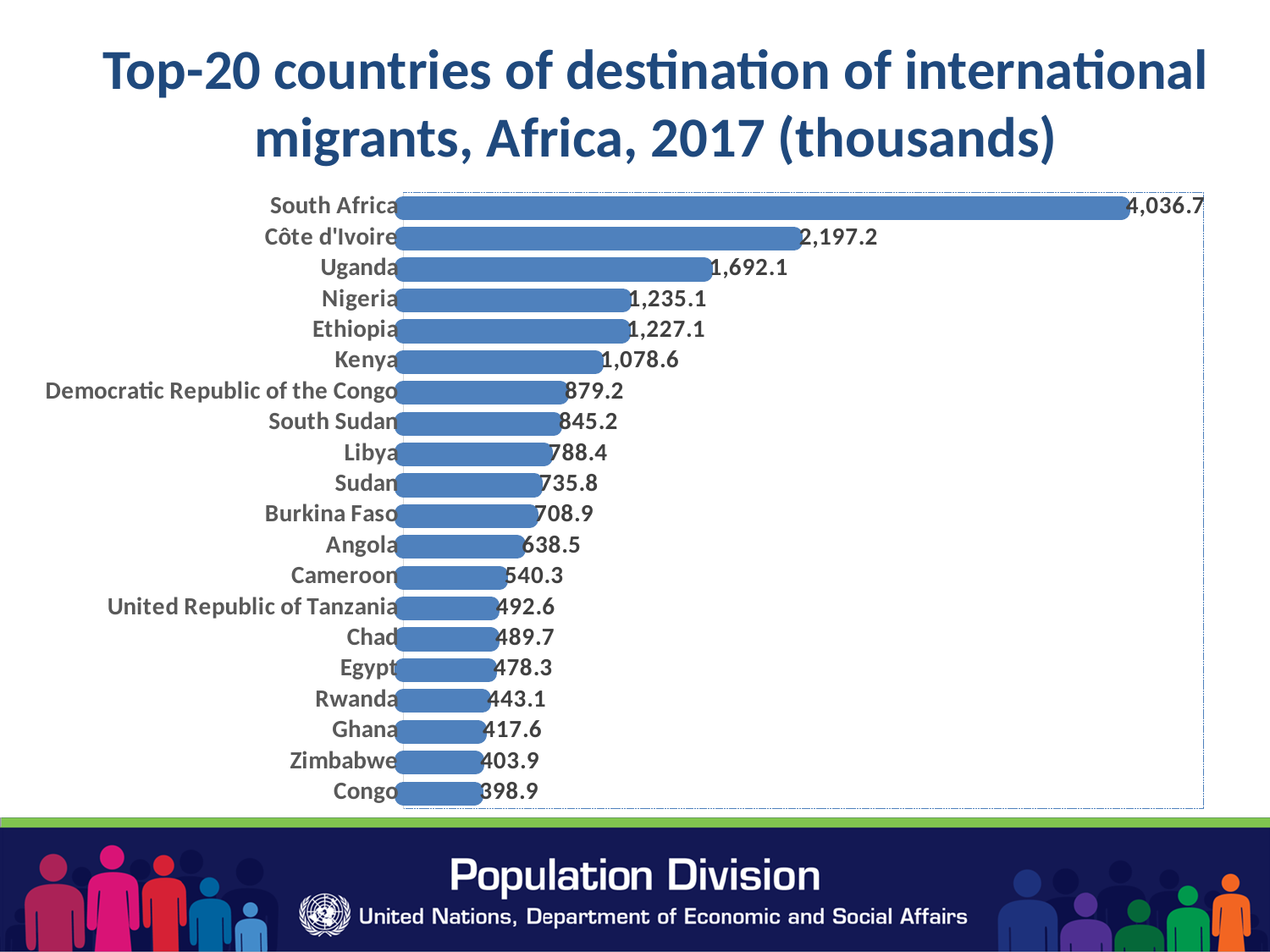
What is the value for Egypt? 478.3 Which country has the highest value? South Africa What kind of chart is shown on the slide? Bar chart What is the title of the chart? Top-20 countries of destination of international migrants, Africa, 2017 (thousands) What is the value for South Africa? 4,036.7 Which country has the lowest value? Congo How many countries are shown in the chart? 20 What is the value for Uganda? 1,692.1 What is the value for Democratic Republic of the Congo? 879.2 What is the difference between the values for Kenya and Democratic Republic of the Congo? 199.4 What is the difference between the values for South Africa and Côte d'Ivoire? 1,839.5 Which has a larger value, Nigeria or Ethiopia? Nigeria